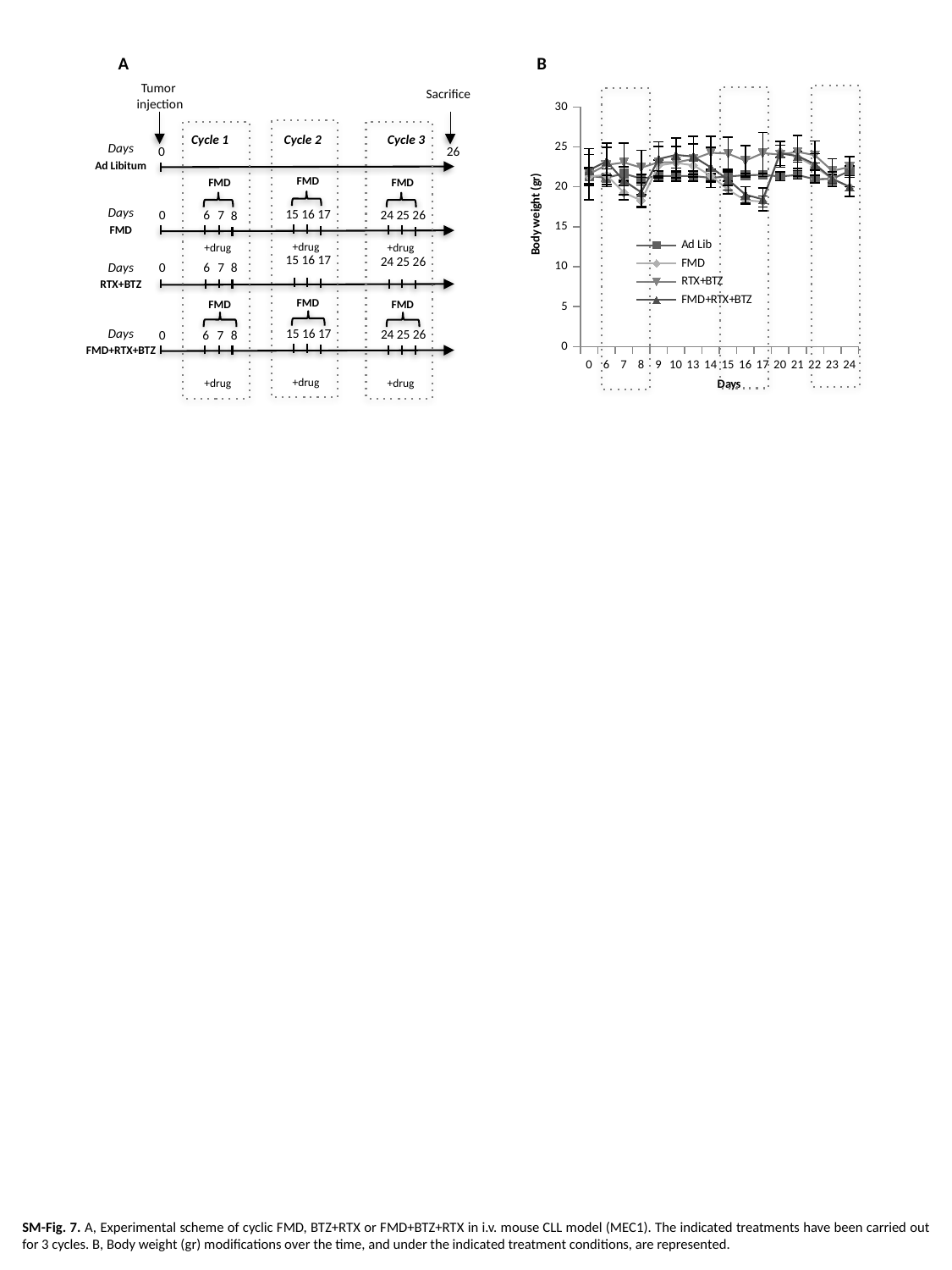
In chart B, is the value for Ad Lib at day 24 greater or less than 10? greater In chart B, what is the label of the y axis? Body weight (gr) In chart B, how many day points are labelled along the x axis? 16 In chart B, is the value for FMD+RTX+BTZ at day 17 greater or less than 25? less In chart B, how many series does the legend list? 4 In chart B, is the value for FMD at day 10 greater or less than 30? less In chart B, what kind of chart is used to show body weight over time? line chart In chart B, which series is listed last in the legend? FMD+RTX+BTZ